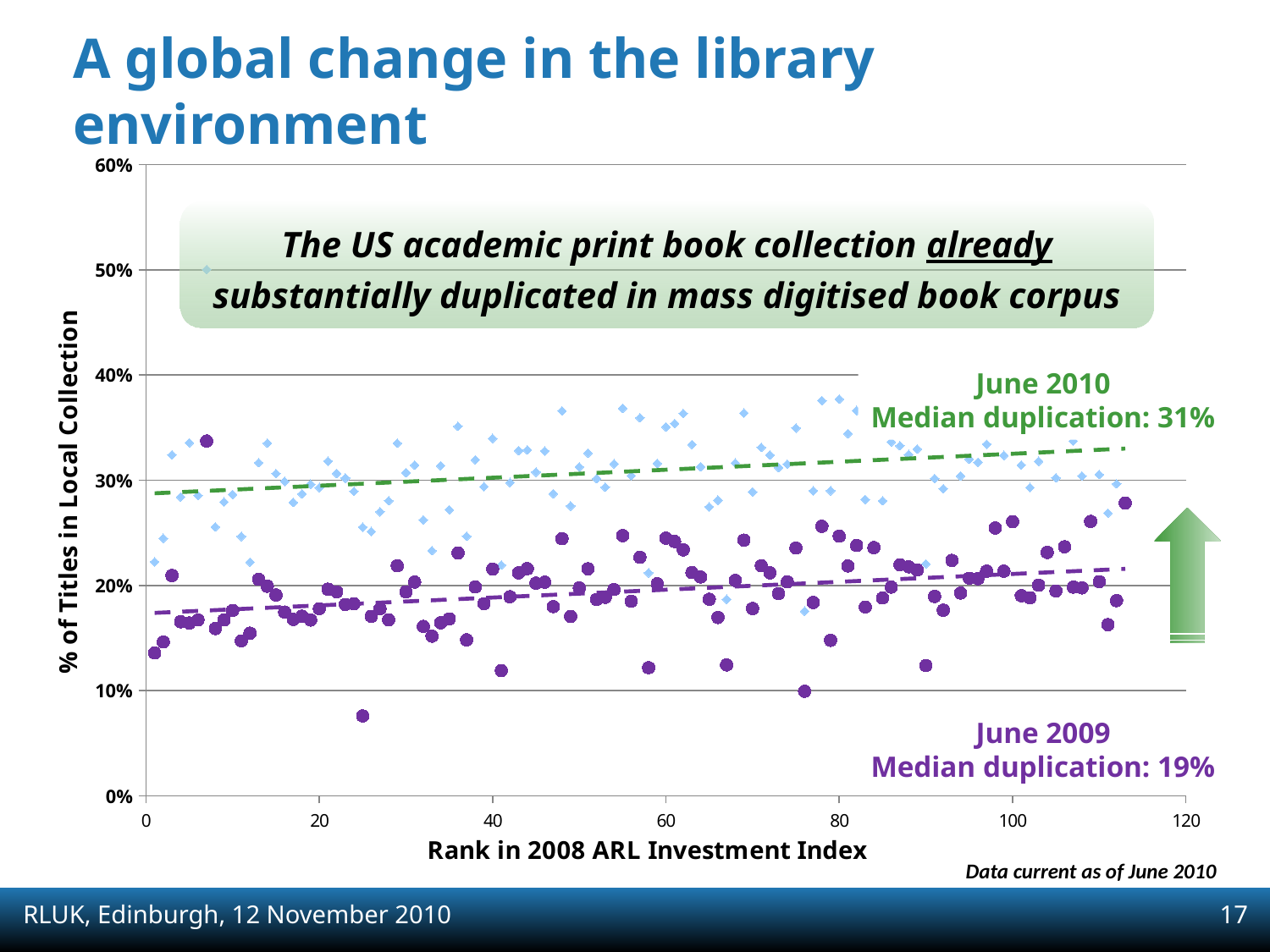
What is the median duplication for June 2009? 19% What is the maximum value shown on the y axis? 60% How many data series are plotted on the chart? 2 Is the lowest June 2009 point on the chart greater or less than 10%? less Does the dashed trend line for the June 2010 series rise or fall as rank increases along the x axis? Rise What is the label of the x axis? Rank in 2008 ARL Investment Index What kind of chart is shown on the slide? Scatter chart Is the highest June 2010 point on the chart greater or less than 40%? greater What is the label of the y axis? % of Titles in Local Collection What is the median duplication for June 2010? 31% Which has the higher median duplication, June 2009 or June 2010? June 2010 By how many percentage points does the June 2010 median duplication exceed the June 2009 median duplication? 12 percentage points